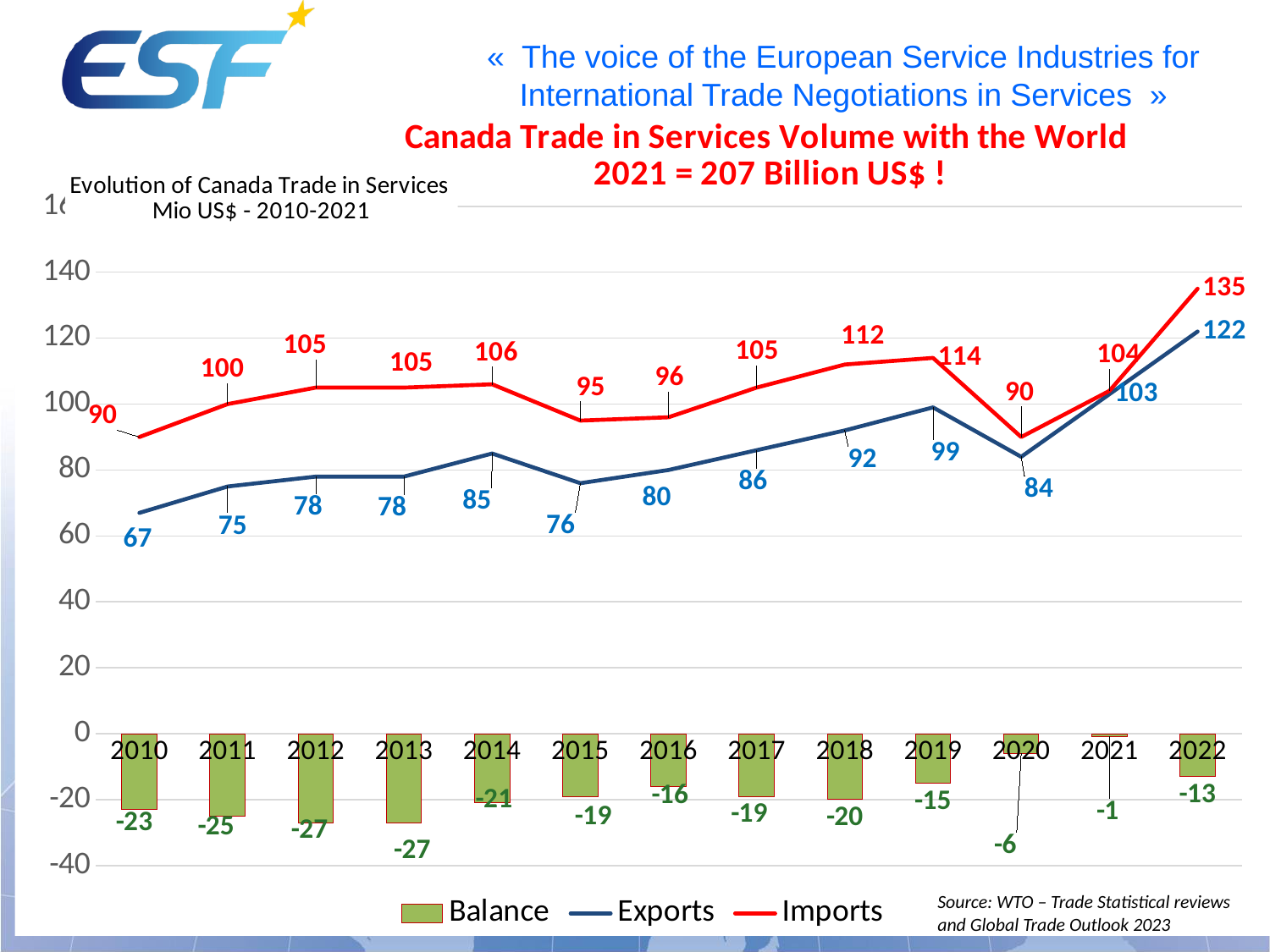
In which year are Exports lowest? 2010 How many series does the legend list? 3 How many years are shown on the x axis? 13 What is the value of Exports in 2010? 67 In which year are Imports highest? 2022 Which series is drawn in red? Imports Is the value of Exports in 2021 greater or less than 100? greater What is the difference between Imports and Exports in 2022? 13 What is the value of Imports in 2018? 112 Do Exports rise or fall from 2019 to 2020? fall What is the Balance value for 2020? -6 Which is larger in 2019, Exports or Imports? Imports